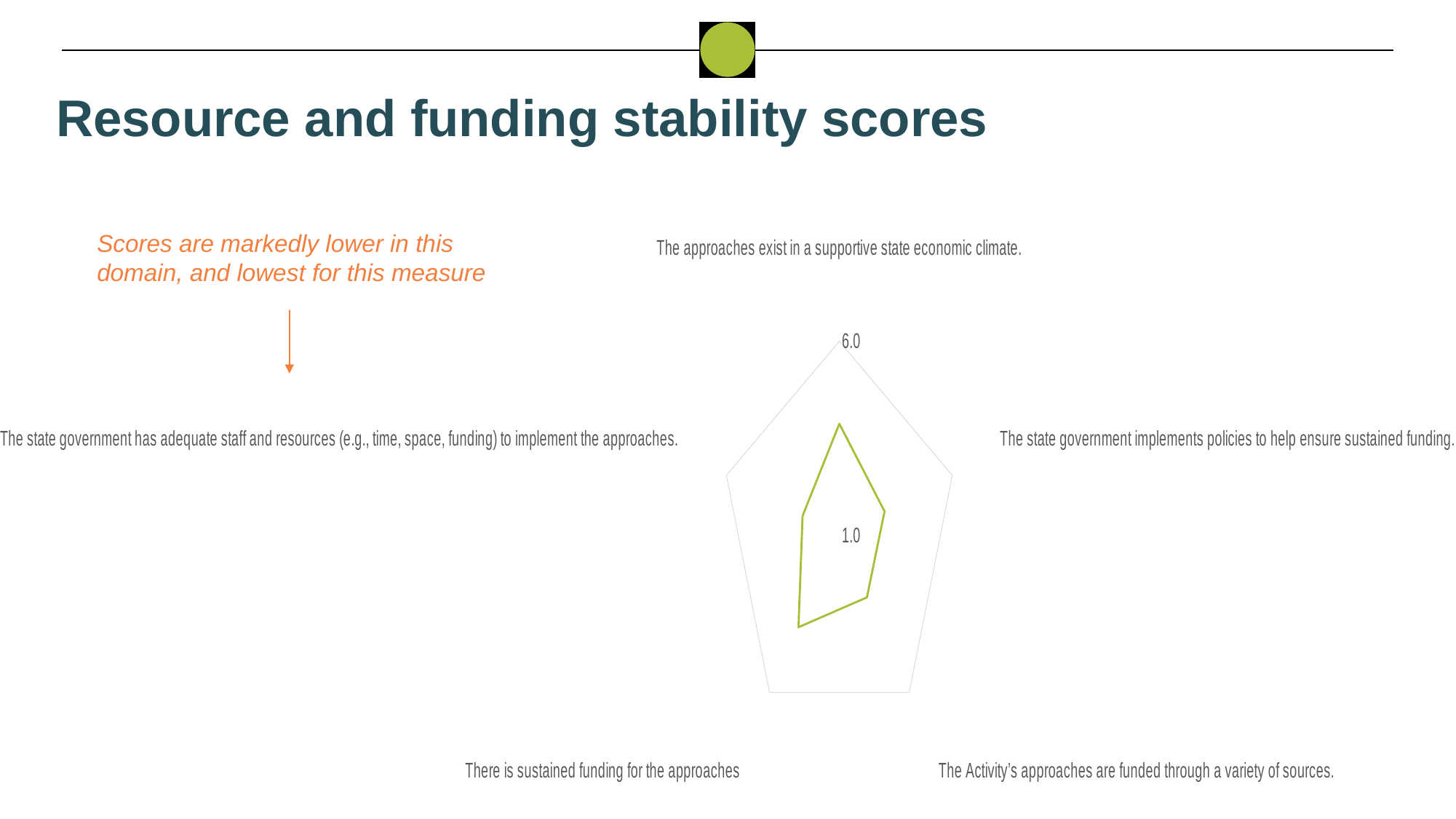
Which has the larger value: 'There is sustained funding for the approaches' or 'The state government implements policies to help ensure sustained funding.'? There is sustained funding for the approaches Which has the larger value: 'The approaches exist in a supportive state economic climate.' or 'The state government has adequate staff and resources (e.g., time, space, funding) to implement the approaches.'? The approaches exist in a supportive state economic climate. Is the value for 'The state government implements policies to help ensure sustained funding.' greater or less than 6.0? less What is the highest value shown on the chart's axis scale? 6.0 Which has the larger value: 'The approaches exist in a supportive state economic climate.' or 'The state government implements policies to help ensure sustained funding.'? The approaches exist in a supportive state economic climate. What kind of chart is shown on the slide? Radar chart How many measures (axes) does the radar chart have? 5 Is the value for 'There is sustained funding for the approaches' greater or less than 1.0? greater What is the title of the slide containing the chart? Resource and funding stability scores Is the value for 'The approaches exist in a supportive state economic climate.' greater or less than 6.0? less